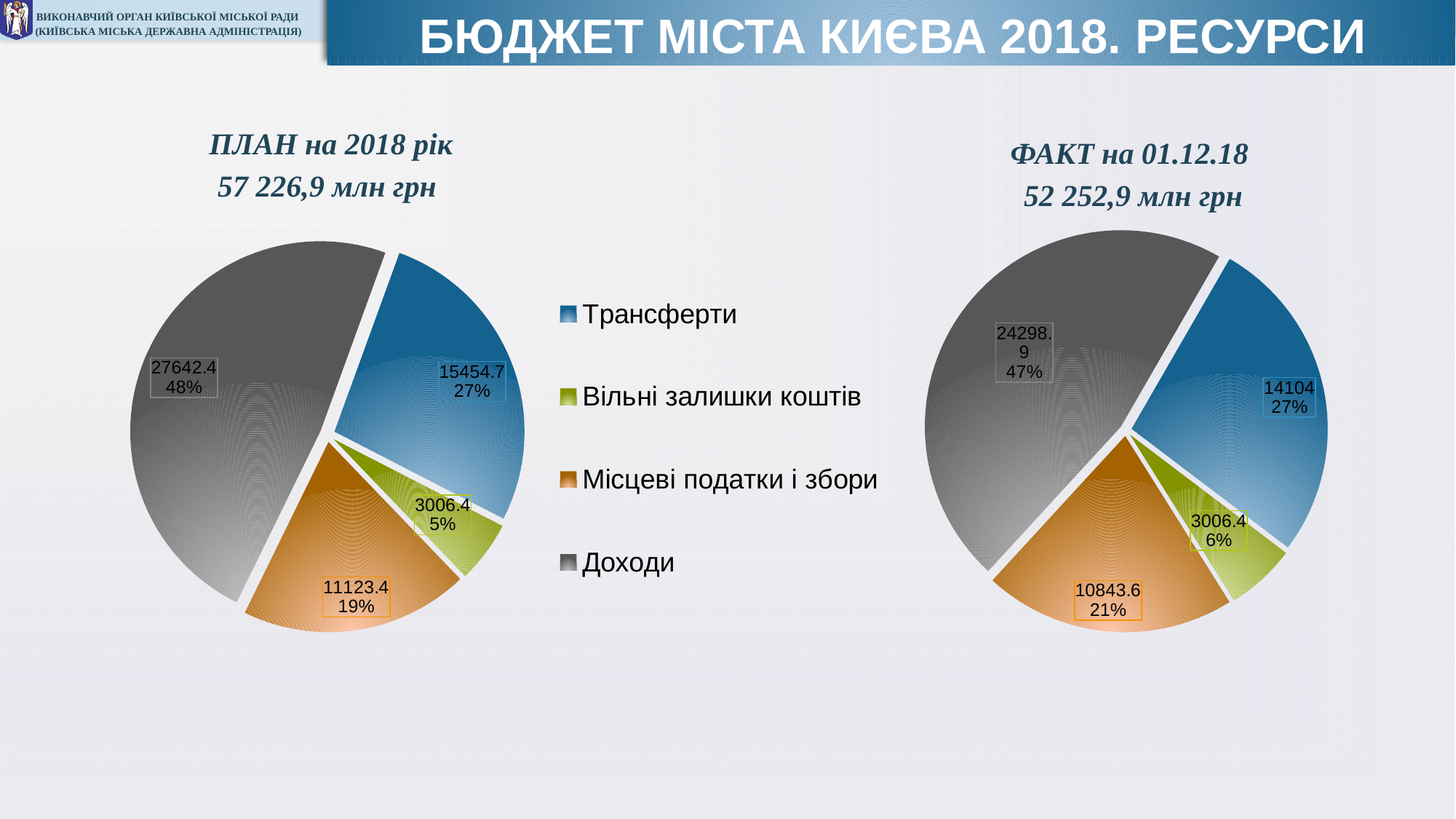
In the ФАКТ на 01.12.18 chart, what share of the pie is Вільні залишки коштів? 6% Which colour represents Місцеві податки і збори in the legend? Orange In the ФАКТ на 01.12.18 chart, what is the value for Трансферти? 14104 How many entries does the legend list? 4 What type of chart is the ПЛАН на 2018 рік chart? Pie chart In the ФАКТ на 01.12.18 chart, which is larger: Місцеві податки і збори or Трансферти? Трансферти In the ФАКТ на 01.12.18 chart, which category has the largest slice? Доходи In the ПЛАН на 2018 рік chart, what share of the pie is Місцеві податки і збори? 19% In the ПЛАН на 2018 рік chart, what is the value for Доходи? 27642.4 In the ПЛАН на 2018 рік chart, what is the difference between the values for Доходи and Трансферти? 12187.7 How many slices does the ФАКТ на 01.12.18 chart have? 4 In the ПЛАН на 2018 рік chart, which category has the smallest slice? Вільні залишки коштів